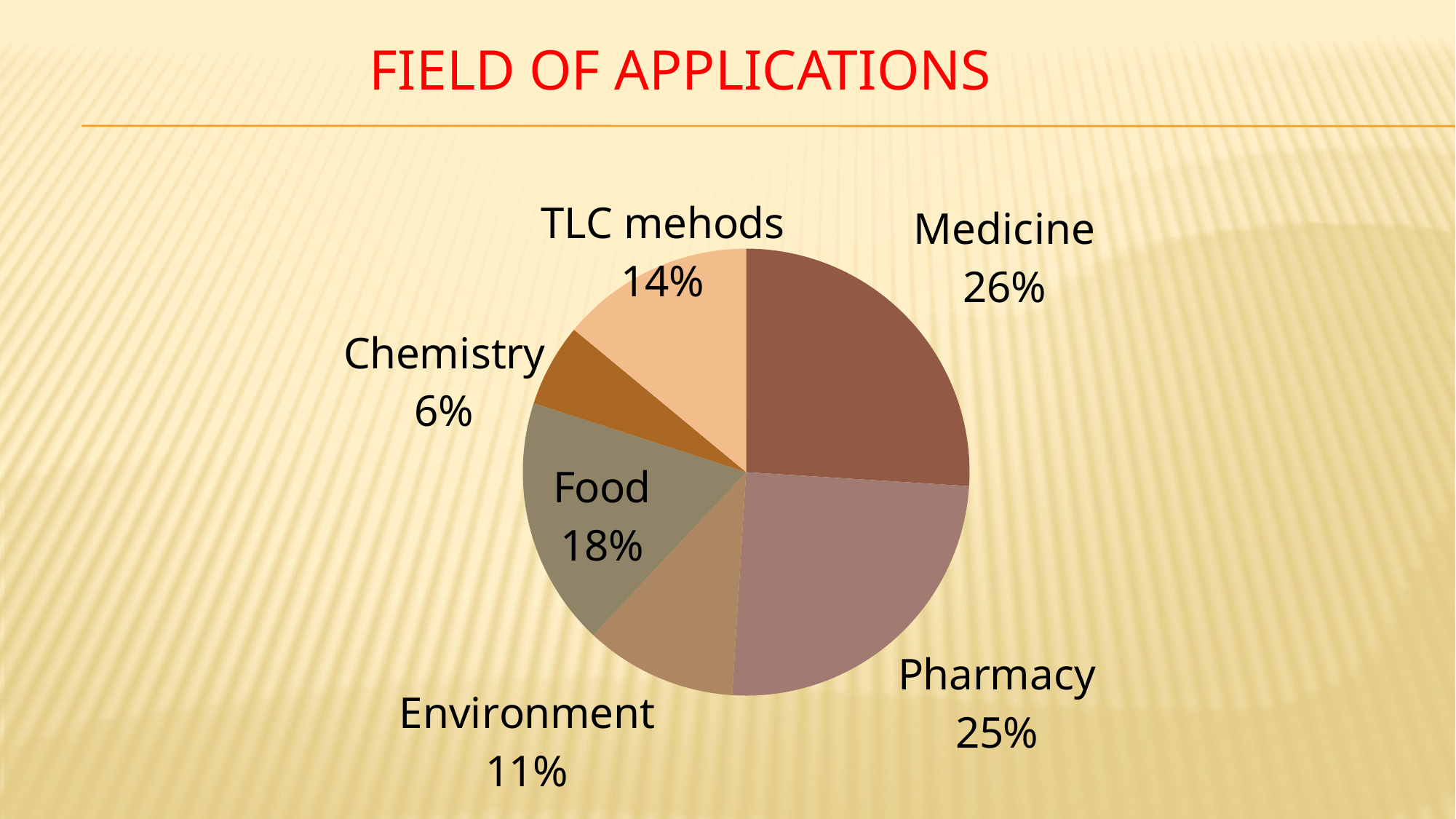
What kind of chart is shown on the slide? pie chart What is the difference between the values for Medicine and Pharmacy? 1% What is the title of the slide containing the chart? FIELD OF APPLICATIONS What is the value for Food? 18% Which is larger, the value for TLC mehods or the value for Environment? TLC mehods How many categories are shown in the pie chart? 6 Which category has the largest share of the pie? Medicine What is the difference between the values for Food and Chemistry? 12% What is the value for Medicine? 26% What is the value for Environment? 11% Which category has the smallest share of the pie? Chemistry What is the value for TLC mehods? 14%